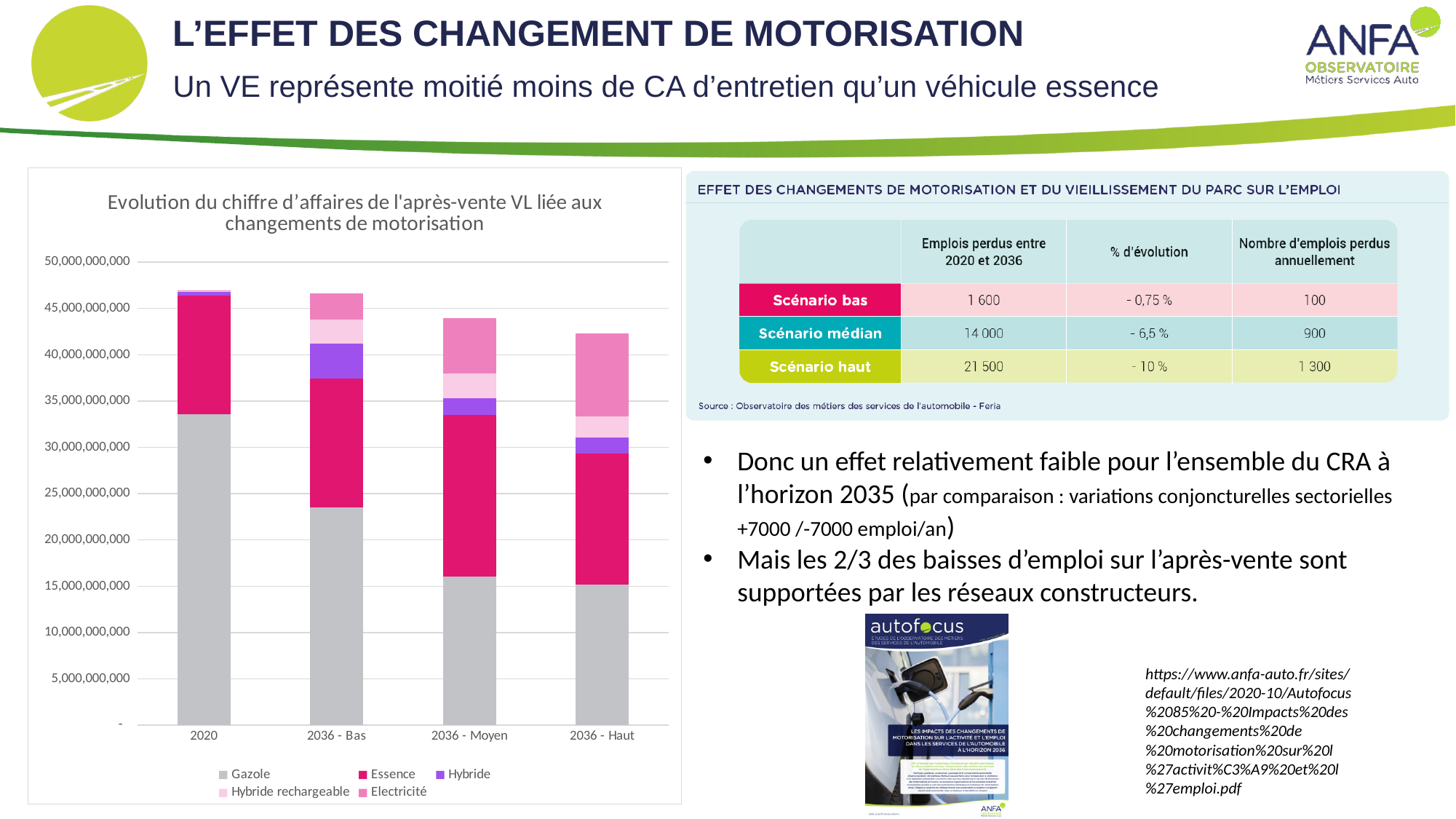
Is the Gazole value for 2036 - Bas greater or less than 20,000,000,000? greater Which series is shown in grey in the chart? Gazole Which category has the highest Gazole value? 2020 What kind of chart is shown on the slide? Stacked bar chart Which category has the lowest total bar height? 2036 - Haut Which is larger, the Electricité segment for 2036 - Haut or for 2036 - Bas? 2036 - Haut What is the title of the chart? Evolution du chiffre d'affaires de l'après-vente VL liée aux changements de motorisation How many series does the chart legend list? 5 Do the total bar heights rise or fall from 2020 to 2036 - Haut? fall How many categories are shown on the x axis of the chart? 4 Is the total bar height for 2036 - Haut greater or less than 45,000,000,000? less Is the Gazole value for 2020 greater or less than 30,000,000,000? greater